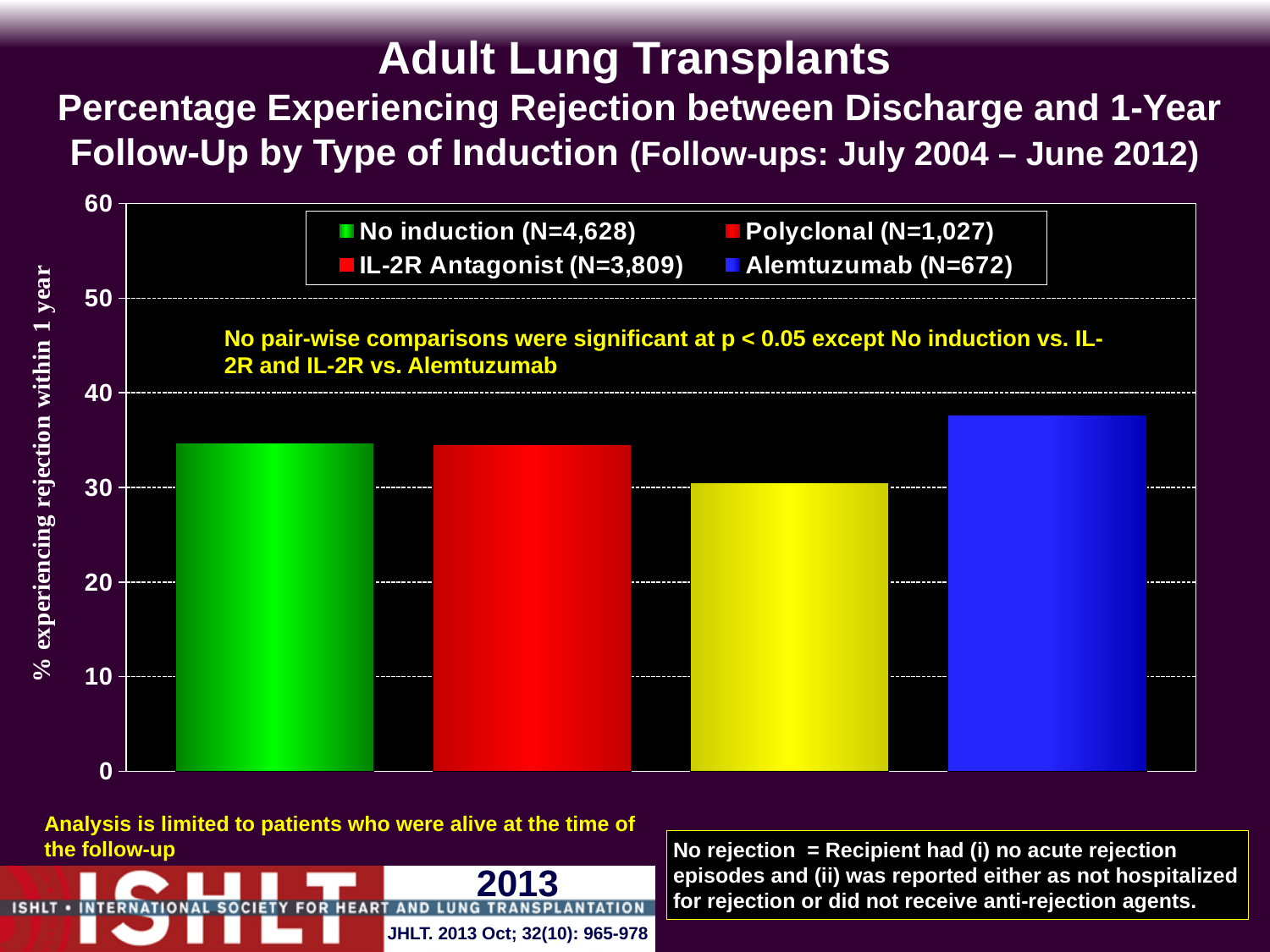
How many bars are plotted in the chart? 4 Which induction type has the highest percentage experiencing rejection within 1 year? Alemtuzumab (N=672) What kind of chart is shown on the slide? bar chart Is the value for No induction greater or less than 30? greater Which induction type has the lowest percentage experiencing rejection within 1 year? IL-2R Antagonist (N=3,809) Is the value for Alemtuzumab greater or less than 40? less Is the value for IL-2R Antagonist greater or less than 40? less Which is larger, the value for Alemtuzumab or the value for IL-2R Antagonist? Alemtuzumab What is the label of the y axis? % experiencing rejection within 1 year Which is larger, the value for No induction or the value for IL-2R Antagonist? No induction How many series does the legend list? 4